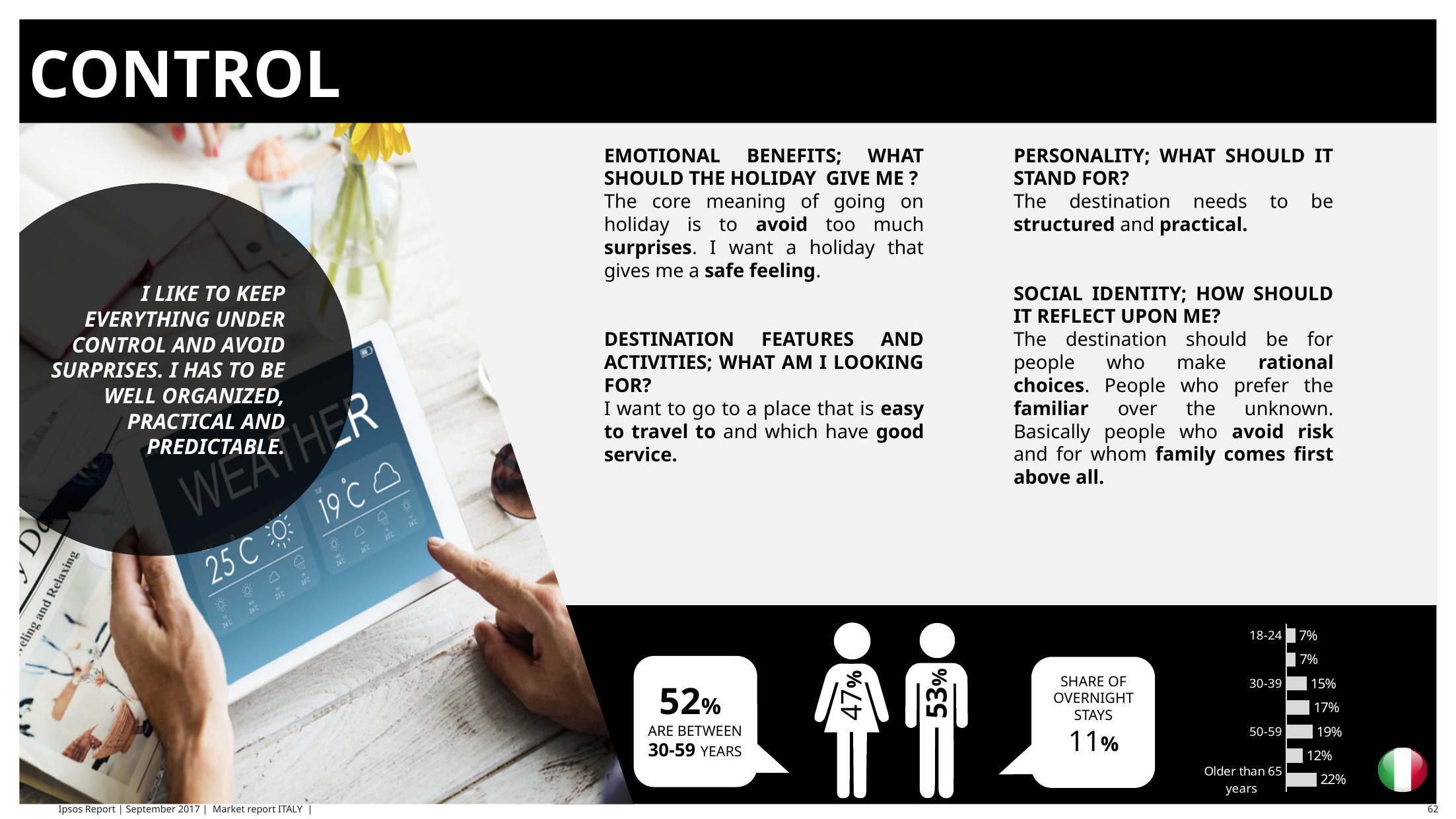
In the age-group bar chart, what is the value for Older than 65 years? 22% In the age-group bar chart, which is larger, the value for Older than 65 years or the value for 18-24? Older than 65 years In the age-group bar chart, what is the difference between the values for Older than 65 years and 18-24? 15% In the age-group bar chart, what is the value for 50-59? 19% In the age-group bar chart, what is the value for 30-39? 15% What type of chart is shown at the bottom right of the slide? bar chart In the age-group bar chart, what is the value for 18-24? 7% In the age-group bar chart, which labelled age group has the highest value? Older than 65 years In the age-group bar chart, what is the difference between the values for 50-59 and 30-39? 4% Do the values in the age-group bar chart generally rise or fall from the youngest group (18-24) to the oldest (Older than 65 years)? rise How many bars are plotted in the age-group bar chart? 7 In the age-group bar chart, which is larger, the value for 50-59 or the value for 30-39? 50-59